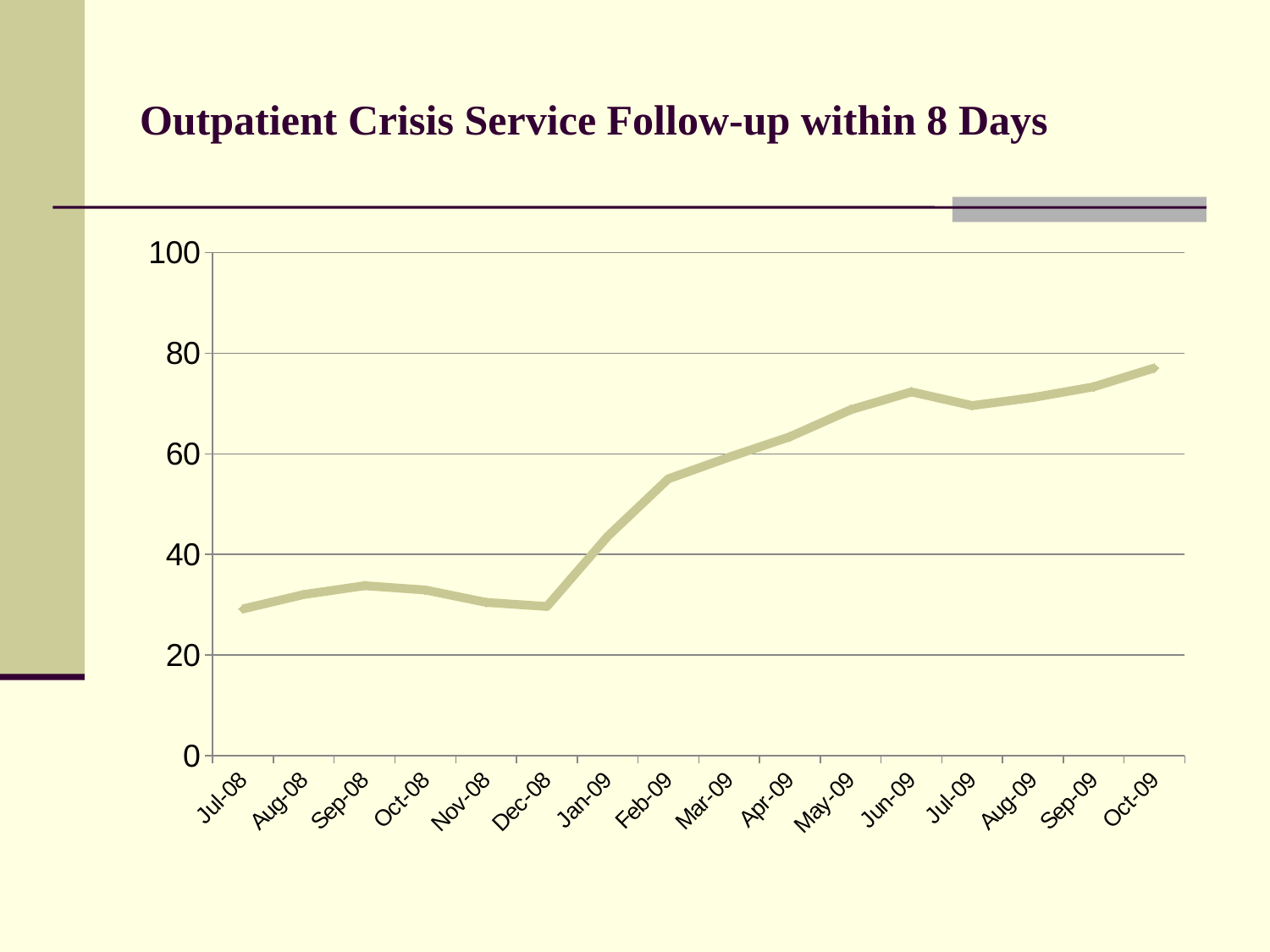
Is the value for Oct-09 greater or less than 80? less Overall, do the values rise or fall from Jul-08 to Oct-09? rise Is the value for Dec-08 greater or less than 20? greater Which month has the highest value on the chart? Oct-09 Which is larger, the value for Feb-09 or the value for Dec-08? Feb-09 Is the value for Jun-09 greater or less than 60? greater What is the title of the slide? Outpatient Crisis Service Follow-up within 8 Days Which is larger, the value for Oct-09 or the value for Jul-08? Oct-09 How many months are plotted along the x axis? 16 What kind of chart is shown on the slide? line chart